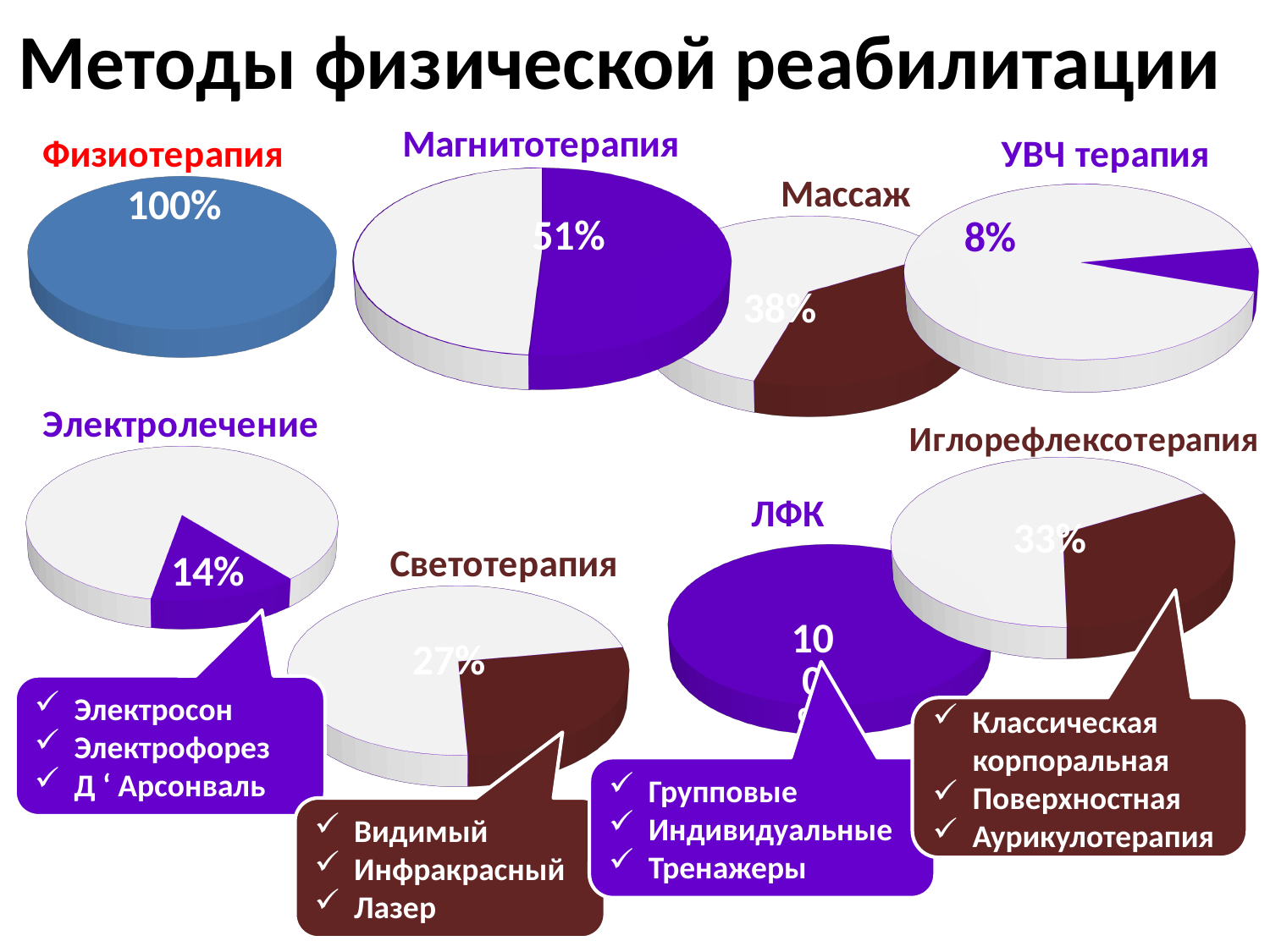
In the Магнитотерапия pie chart, what percentage is shown for the coloured slice? 51% In the Иглорефлексотерапия pie chart, what percentage is printed? 33% In the УВЧ терапия pie chart, what percentage is shown? 8% What kind of chart is used for Магнитотерапия on this slide? Pie chart In the Электролечение pie chart, what percentage is printed on the slice? 14% What is the title of the slide containing these pie charts? Методы физической реабилитации In the Массаж pie chart, what percentage is printed on the slice? 38% Among the charts for Магнитотерапия, Массаж, УВЧ терапия, Электролечение, Светотерапия and Иглорефлексотерапия, which shows the lowest printed percentage? УВЧ терапия Which has the larger printed percentage: the Магнитотерапия chart or the Массаж chart? Магнитотерапия In the Светотерапия pie chart, what percentage is shown? 27% In the Физиотерапия pie chart, what percentage is shown? 100% What is the difference between the percentage printed on the Массаж chart and the percentage printed on the УВЧ терапия chart? 30%